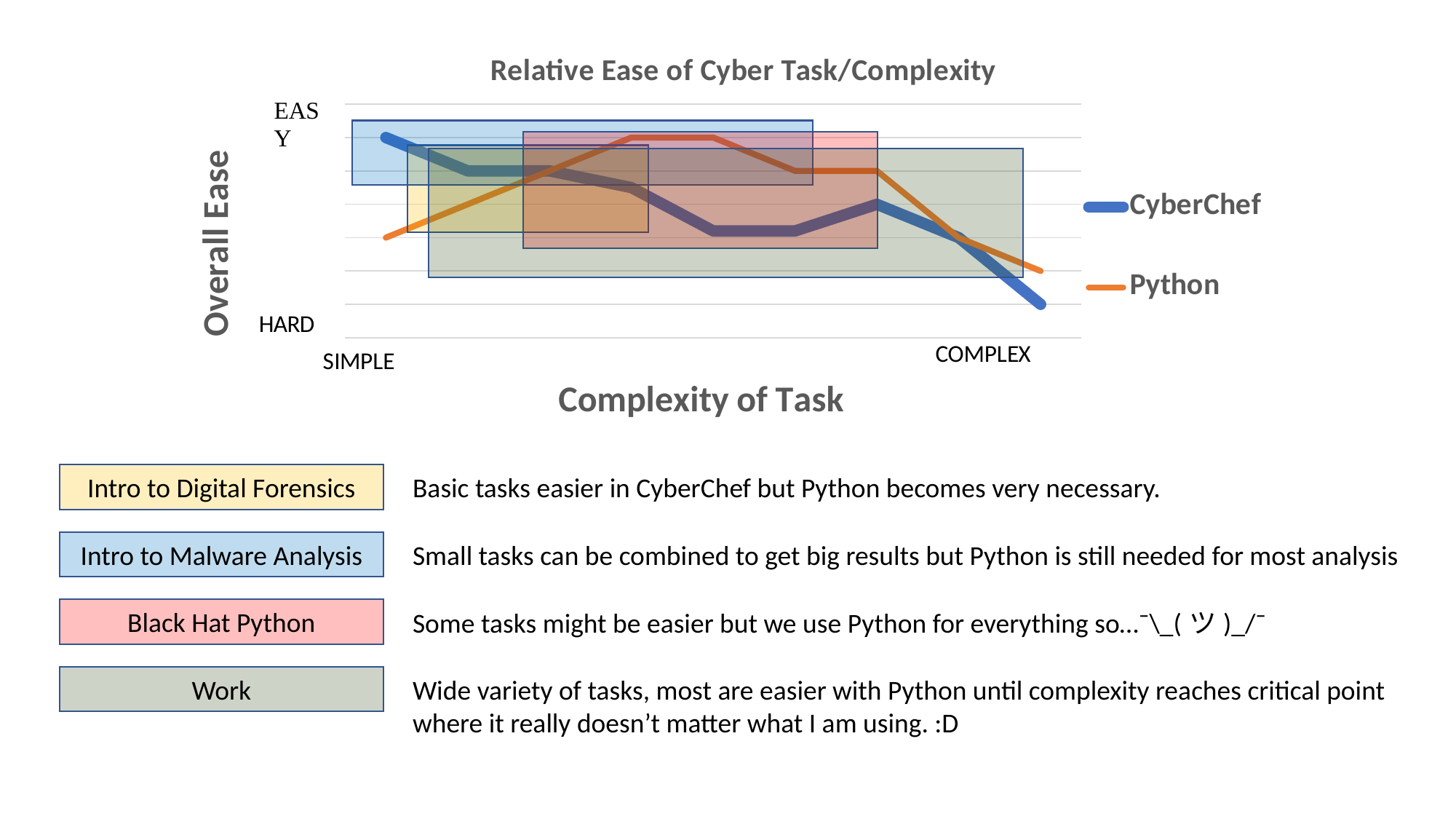
At the COMPLEX end of the x axis, which series has the higher overall ease, CyberChef or Python? Python What type of chart is shown on the slide? Line chart At the SIMPLE end of the x axis, which series has the higher overall ease, CyberChef or Python? CyberChef Overall, does the CyberChef line rise or fall as task complexity goes from SIMPLE to COMPLEX? Fall Which series is drawn in blue in the chart? CyberChef What is the title of the chart? Relative Ease of Cyber Task/Complexity Which series starts closest to EASY at the SIMPLE end of the chart? CyberChef Does the Python line rise or fall between the SIMPLE end and its peak near the middle of the chart? Rise Which series ends closest to HARD at the COMPLEX end of the chart? CyberChef How many series does the chart legend list? 2